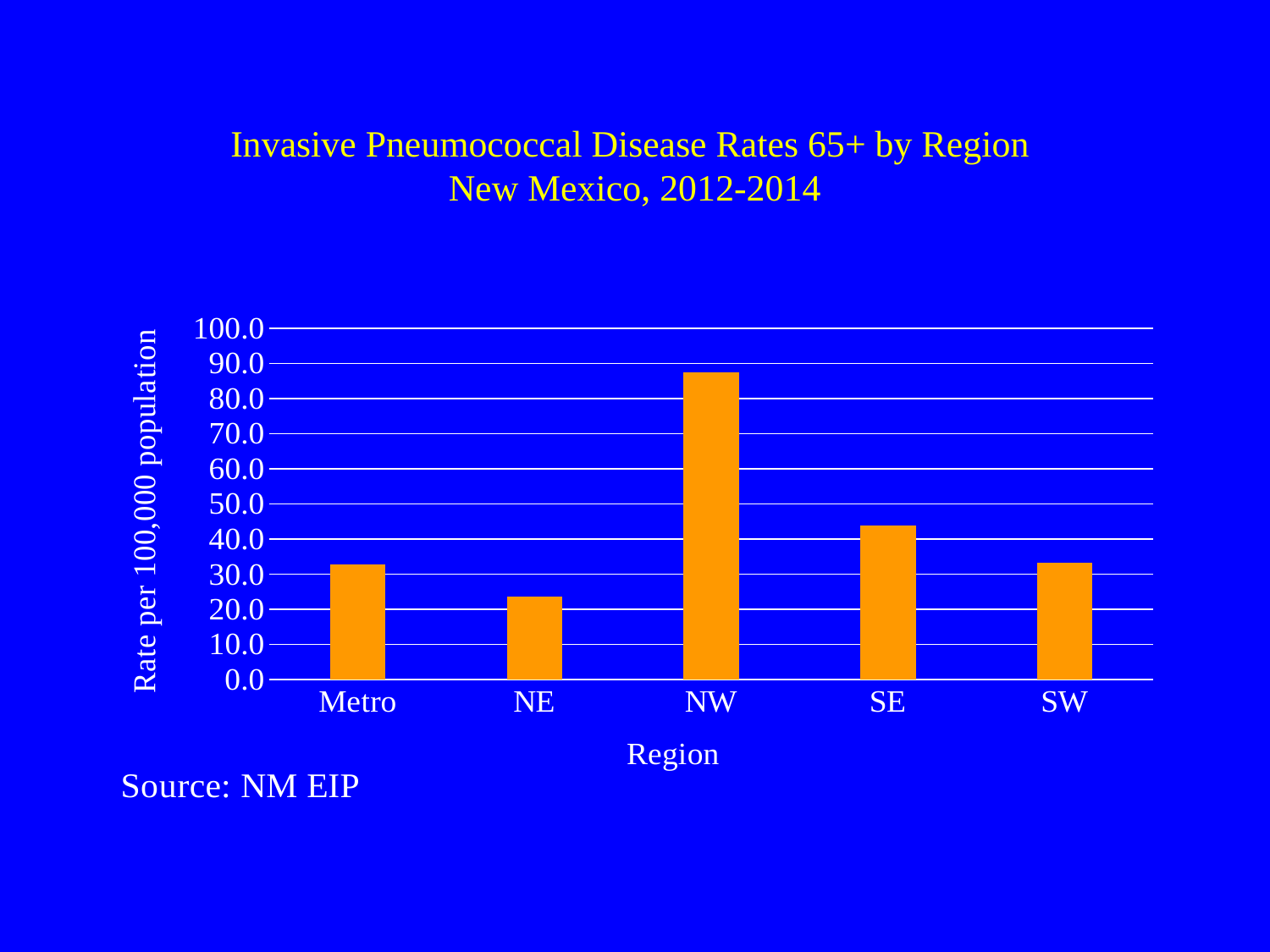
Which region has a higher rate, SE or NE? SE Which region has the lowest invasive pneumococcal disease rate? NE Is the rate for SE greater or less than 50.0? less Is the rate for NW greater or less than 80.0? greater How many regions are shown on the x axis of the chart? 5 What is the label of the y axis of the chart? Rate per 100,000 population Is the rate for Metro greater or less than 40.0? less Which region has a higher rate, NW or SE? NW What source is cited for the chart data? NM EIP What kind of chart is shown on the slide? bar chart Which region has the highest invasive pneumococcal disease rate? NW